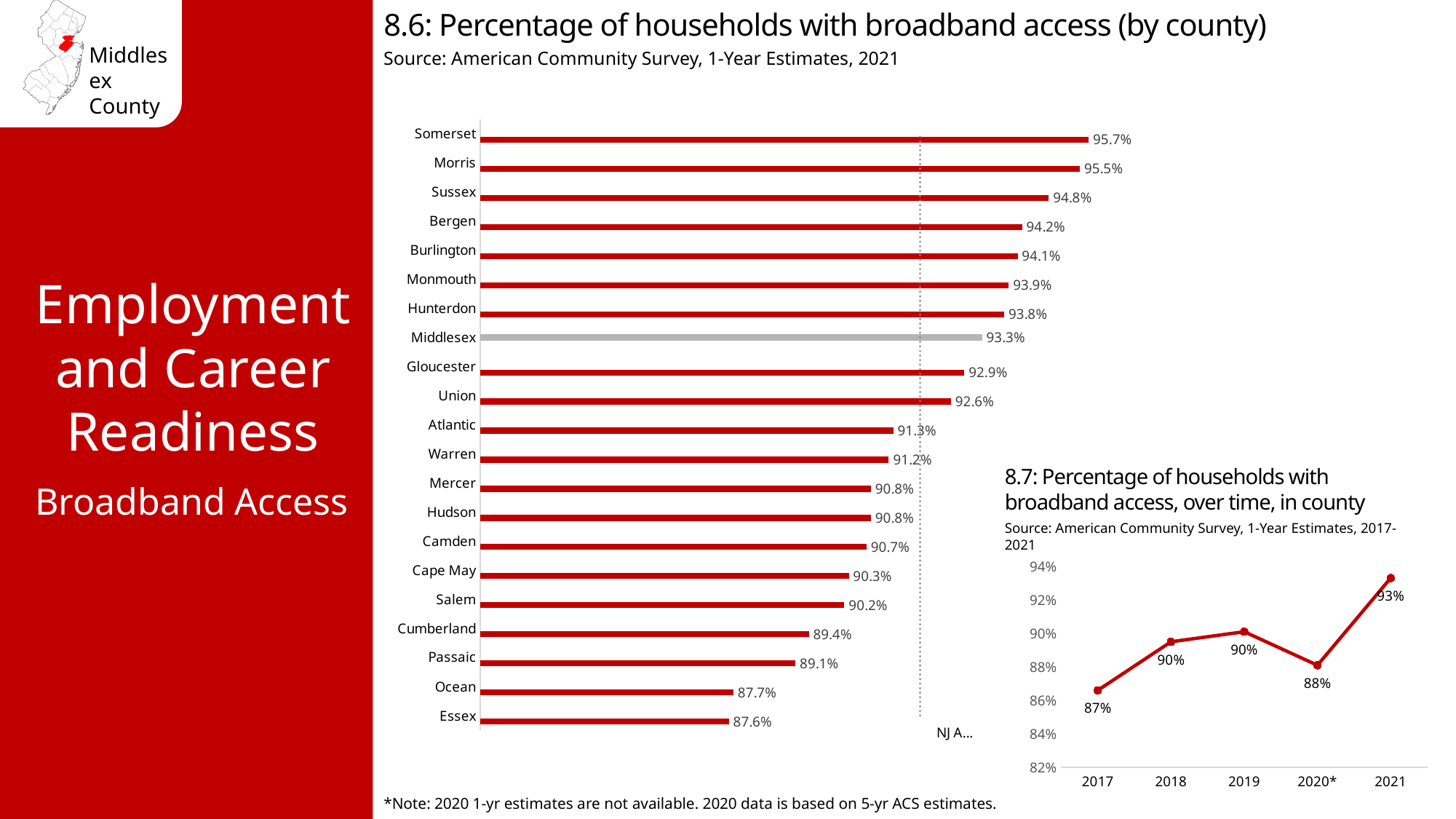
In chart 8.6, which county has the highest percentage of households with broadband access? Somerset In chart 8.6, what is the percentage of households with broadband access in Middlesex? 93.3% In chart 8.6, how many counties are shown? 21 What kind of chart is chart 8.6? Bar chart In chart 8.6, which county has a higher value, Bergen or Gloucester? Bergen In chart 8.7, which year has the lowest percentage of households with broadband access? 2017 In chart 8.6, which county has the lowest percentage of households with broadband access? Essex In chart 8.6, what is the value for Cumberland? 89.4% In chart 8.7, how many data points are plotted? 5 In chart 8.6, what is the difference in percentage points between Somerset and Essex? 8.1 In chart 8.7, what is the difference in percentage points between 2021 and 2020*? 5 In chart 8.7, what is the percentage of households with broadband access in 2021? 93%